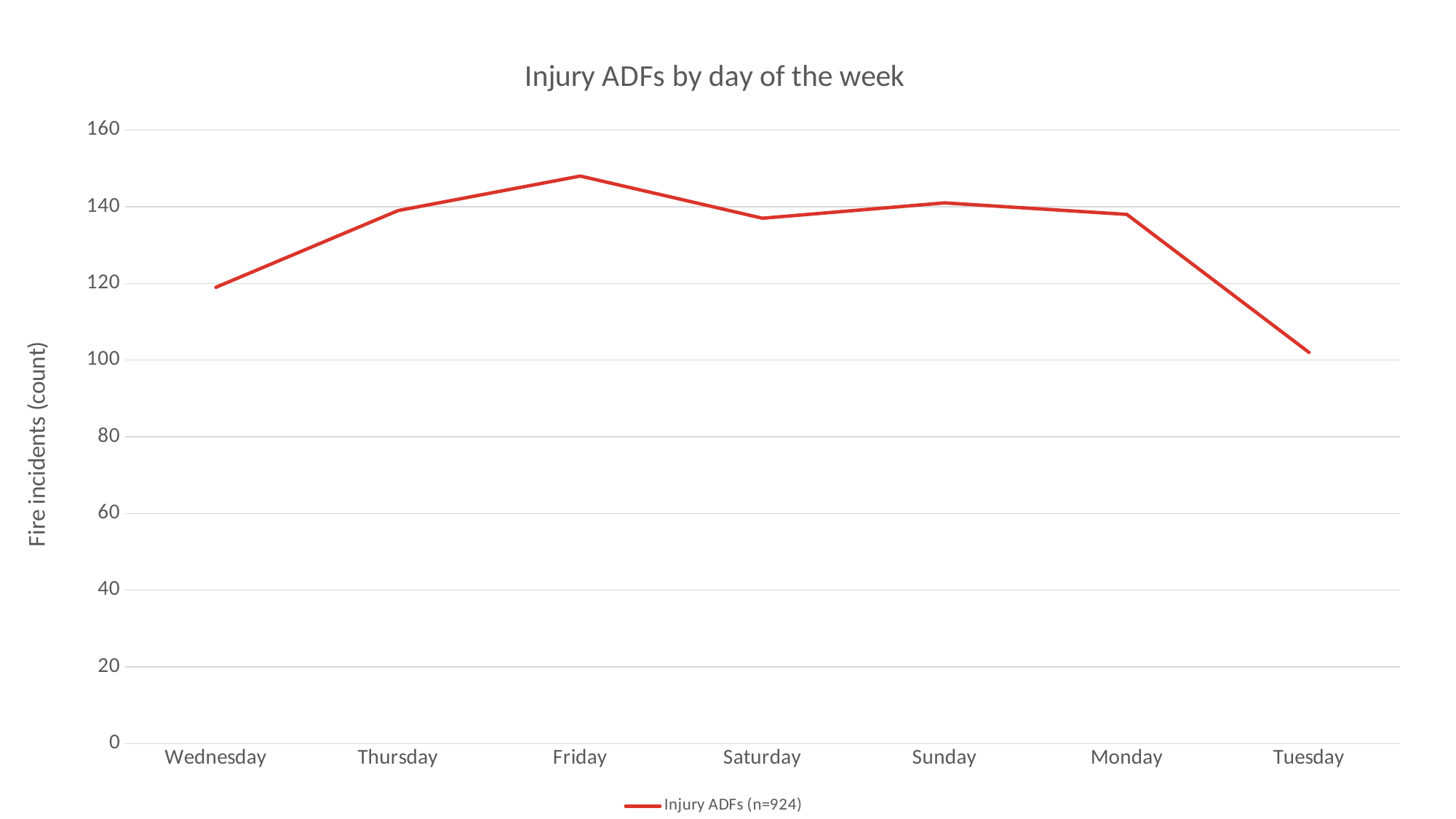
What is the label on the y axis? Fire incidents (count) Is the value for Friday greater or less than 140? greater Is the value for Tuesday greater or less than 120? less Which day has the highest number of injury ADFs? Friday How many series does the legend list? 1 What kind of chart is shown on the slide? line chart Which has fewer injury ADFs, Monday or Tuesday? Tuesday Which has more injury ADFs, Wednesday or Thursday? Thursday Which day has the lowest number of injury ADFs? Tuesday Is the value for Saturday greater or less than 120? greater Do the values rise or fall from Wednesday to Friday? rise How many days of the week are plotted on the x axis? 7